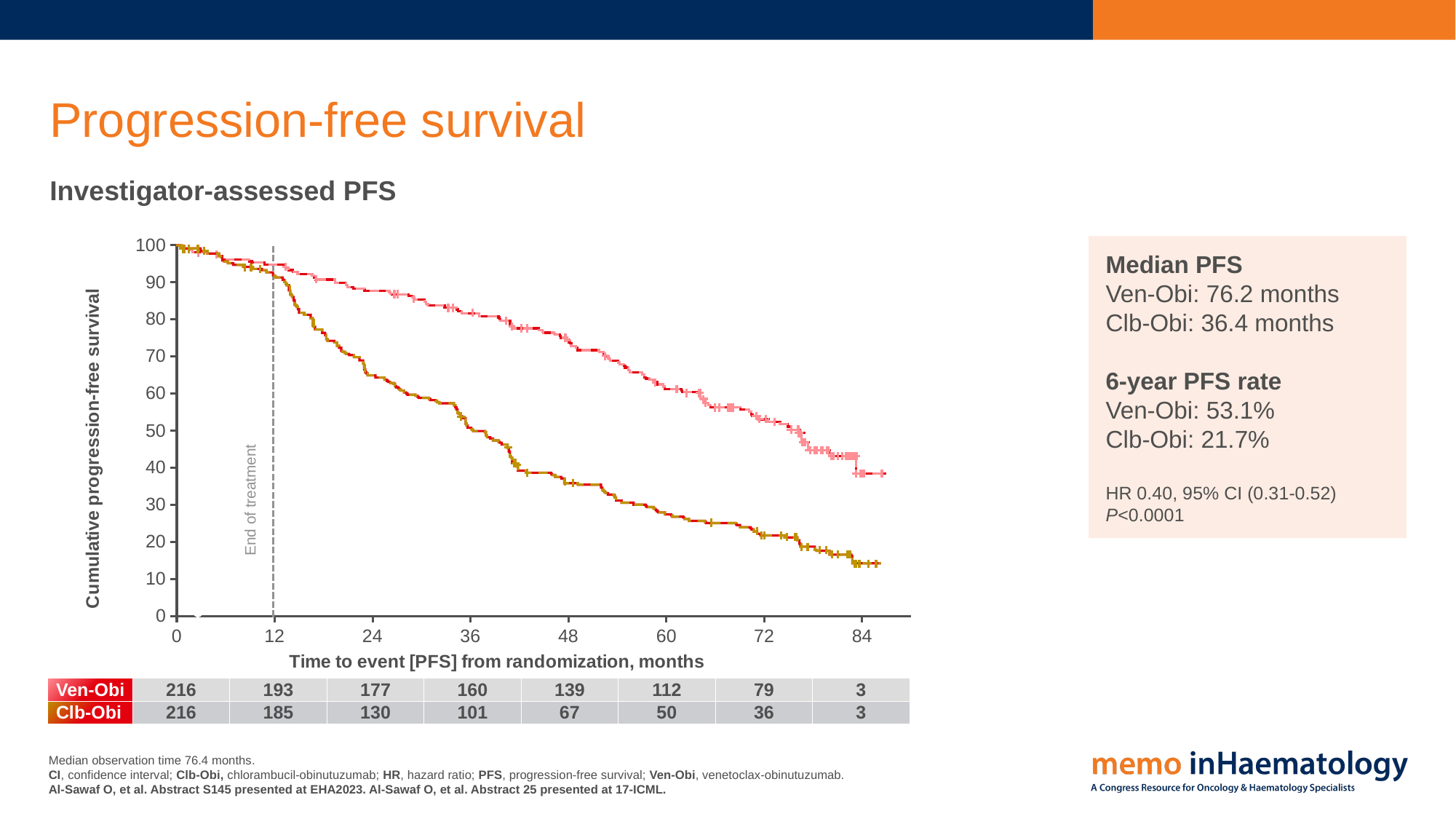
Which arm has the higher 6-year PFS rate, Ven-Obi or Clb-Obi? Ven-Obi What is the difference between the 6-year PFS rates of Ven-Obi and Clb-Obi? 31.4% How many treatment arms (series) are plotted on the chart? 2 What kind of chart is shown on the slide? Line chart (Kaplan-Meier survival curve) Is the cumulative progression-free survival for Ven-Obi at 48 months greater or less than 70? greater What is the 6-year PFS rate for the Clb-Obi arm? 21.7% Do the progression-free survival curves rise or fall as time from randomization increases? Fall How many Clb-Obi patients were at risk at 48 months? 67 What is the difference in the number of patients at risk at 48 months between Ven-Obi and Clb-Obi? 72 What is the median PFS for the Ven-Obi arm? 76.2 months What does the vertical dashed line at 12 months on the chart mark? End of treatment What is the median PFS for the Clb-Obi arm? 36.4 months